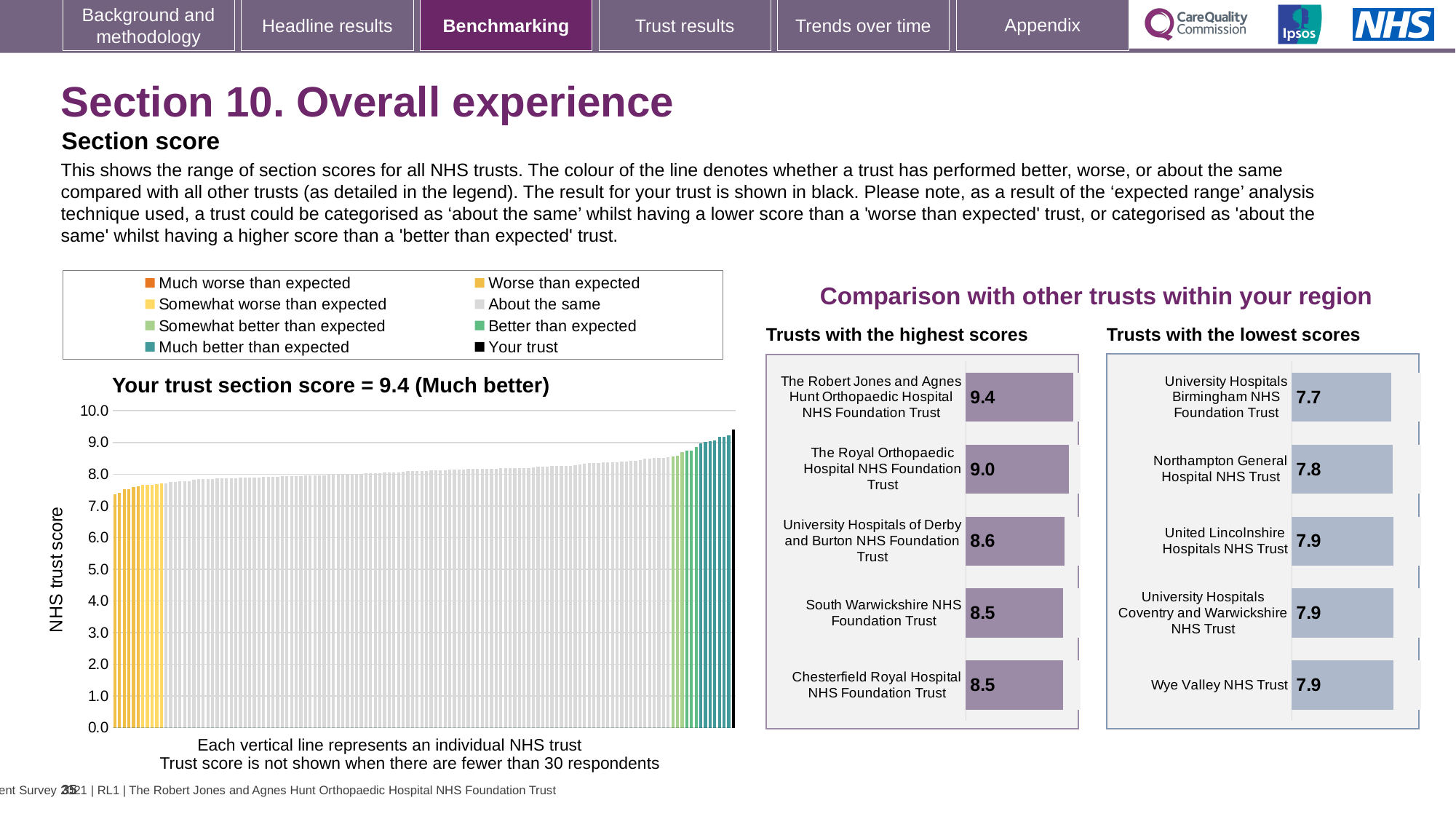
In the 'Trusts with the highest scores' chart, what is the score for The Royal Orthopaedic Hospital NHS Foundation Trust? 9.0 What is the y-axis label of the 'Your trust section score' chart? NHS trust score In the 'Trusts with the highest scores' chart, what is the difference between the scores of The Robert Jones and Agnes Hunt Orthopaedic Hospital NHS Foundation Trust and The Royal Orthopaedic Hospital NHS Foundation Trust? 0.4 What kind of chart is the 'Your trust section score' chart on the left? Bar chart In the 'Trusts with the highest scores' chart, which has the larger score: University Hospitals of Derby and Burton NHS Foundation Trust or South Warwickshire NHS Foundation Trust? University Hospitals of Derby and Burton NHS Foundation Trust In the 'Trusts with the highest scores' chart, how many trusts are listed? 5 In the 'Your trust section score' chart, is the value of the leftmost bar greater or less than 8.0? less In the 'Trusts with the lowest scores' chart, what is the difference between the scores of Wye Valley NHS Trust and University Hospitals Birmingham NHS Foundation Trust? 0.2 In the 'Trusts with the lowest scores' chart, which trust has the lowest score? University Hospitals Birmingham NHS Foundation Trust In the 'Trusts with the highest scores' chart, which trust has the highest score? The Robert Jones and Agnes Hunt Orthopaedic Hospital NHS Foundation Trust In the 'Your trust section score' chart, do the bars rise or fall from left to right? Rise In the 'Trusts with the lowest scores' chart, what is the score for Northampton General Hospital NHS Trust? 7.8